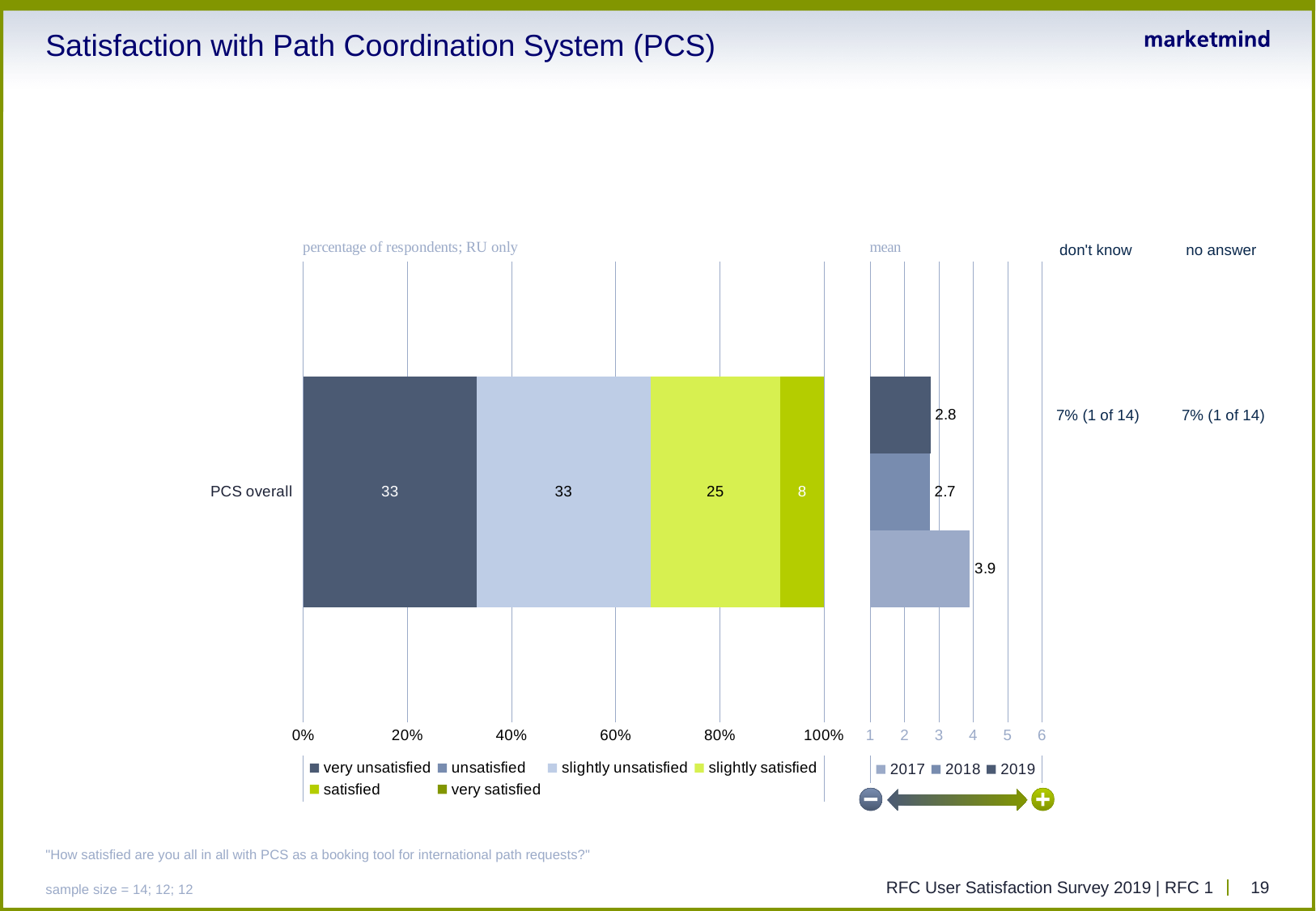
In the mean chart, what is the difference between the 2017 mean and the 2019 mean? 1.1 What kind of chart is the percentage of respondents chart? stacked bar chart In the mean chart, how many years does the legend list? 3 In the percentage of respondents chart, what is the difference between the very unsatisfied and slightly satisfied values for PCS overall? 8 In the percentage of respondents chart, what is the value of the slightly satisfied segment for PCS overall? 25 In the mean chart, what is the mean for 2018? 2.7 In the mean chart, what is the mean for 2019? 2.8 In the percentage of respondents chart, what percentage of respondents are very unsatisfied with PCS overall? 33 In the percentage of respondents chart, what is the value of the rightmost (smallest) segment of the PCS overall bar? 8 In the mean chart, which year has the highest mean? 2017 In the percentage of respondents chart, how many series does the legend list? 6 In the mean chart, what is the mean for 2017? 3.9